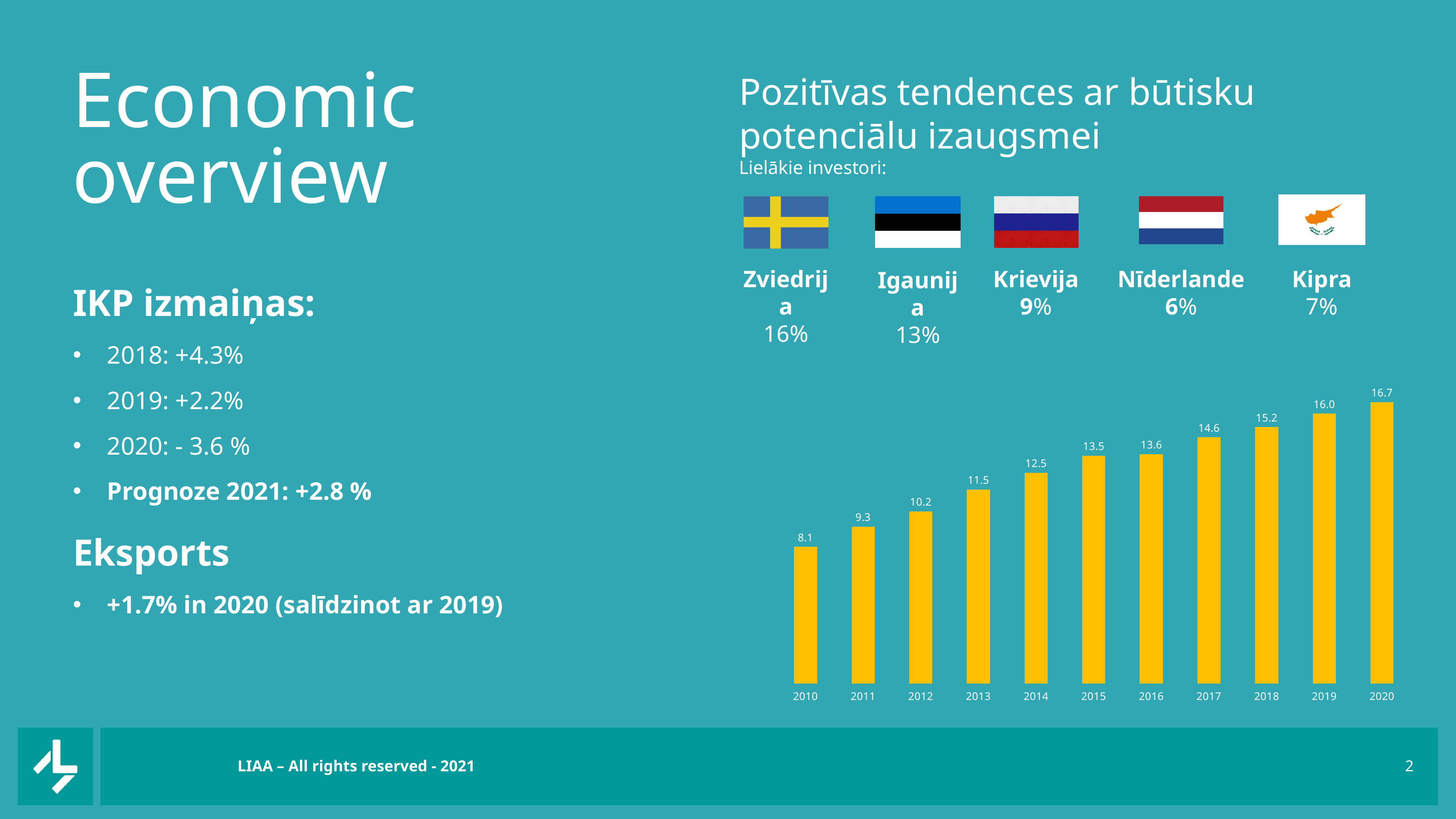
What kind of chart is shown on the slide? bar chart Which is larger in the bar chart, the value for 2012 or the value for 2017? 2017 What is the value shown for 2020 in the bar chart? 16.7 What is the value shown for 2010 in the bar chart? 8.1 How many years are shown in the bar chart? 11 What is the value shown for 2015 in the bar chart? 13.5 Which year has the highest value in the bar chart? 2020 What is the difference between the values for 2014 and 2013 in the bar chart? 1.0 Which year has the lowest value in the bar chart? 2010 Do the values in the bar chart rise or fall from 2010 to 2020? rise What is the difference between the values for 2020 and 2010 in the bar chart? 8.6 What colour are the bars in the chart? yellow